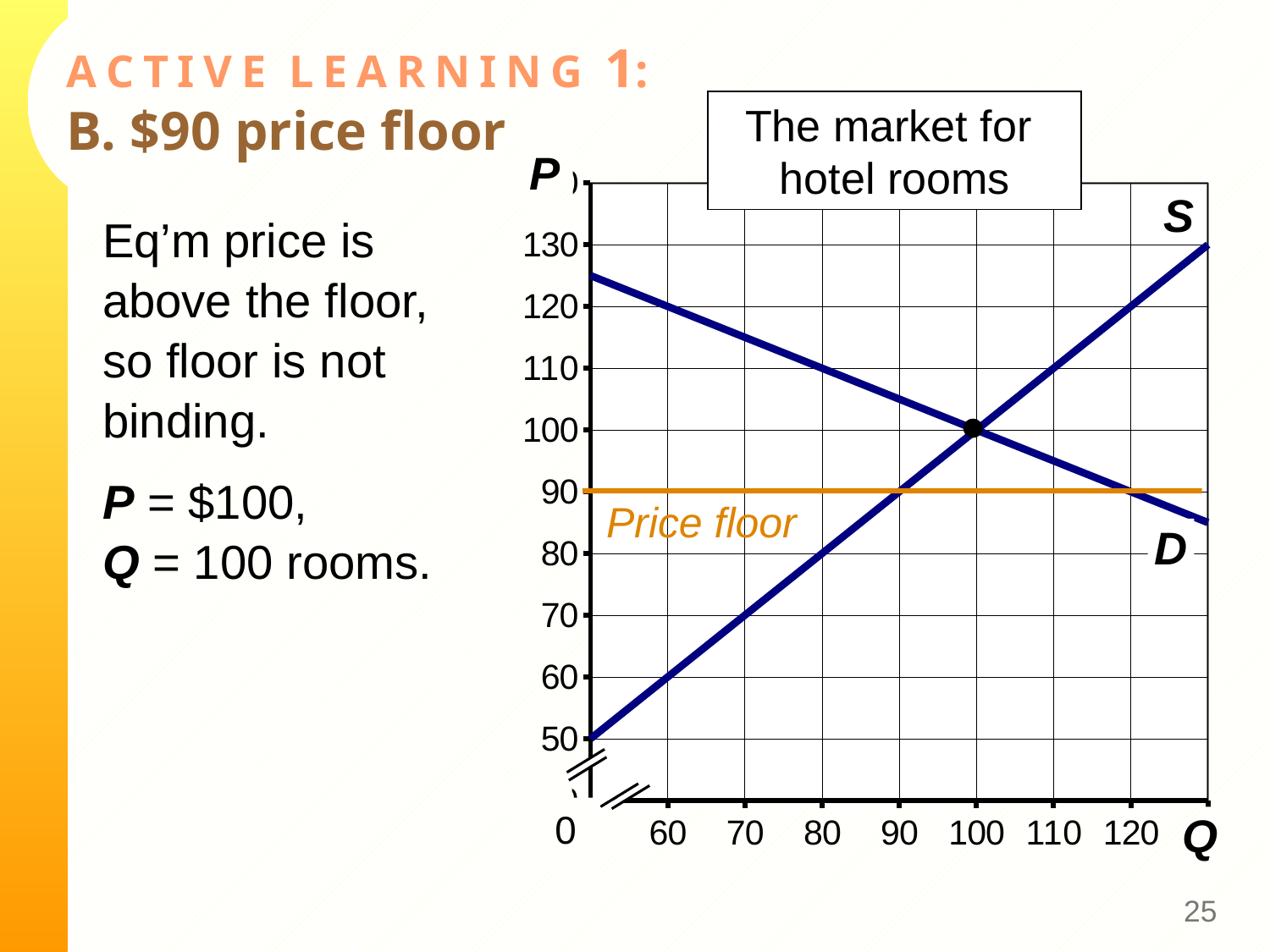
At a quantity of 120, which curve shows the higher price, S or D? S Does the supply curve S rise or fall as quantity increases along the x axis? rise At a quantity of 60, is the price on the supply curve greater or less than 80? less At what price is the price floor drawn in the chart? 90 What colour is the price floor line in the chart? orange What is the title of the chart? The market for hotel rooms What type of chart is shown on the slide? line chart What is the equilibrium quantity shown in the chart? 100 rooms At a quantity of 60, is the price on the demand curve greater or less than 110? greater Does the demand curve D rise or fall as quantity increases along the x axis? fall What is the equilibrium price shown in the chart? $100 Is the price floor greater or less than the equilibrium price of 100? less